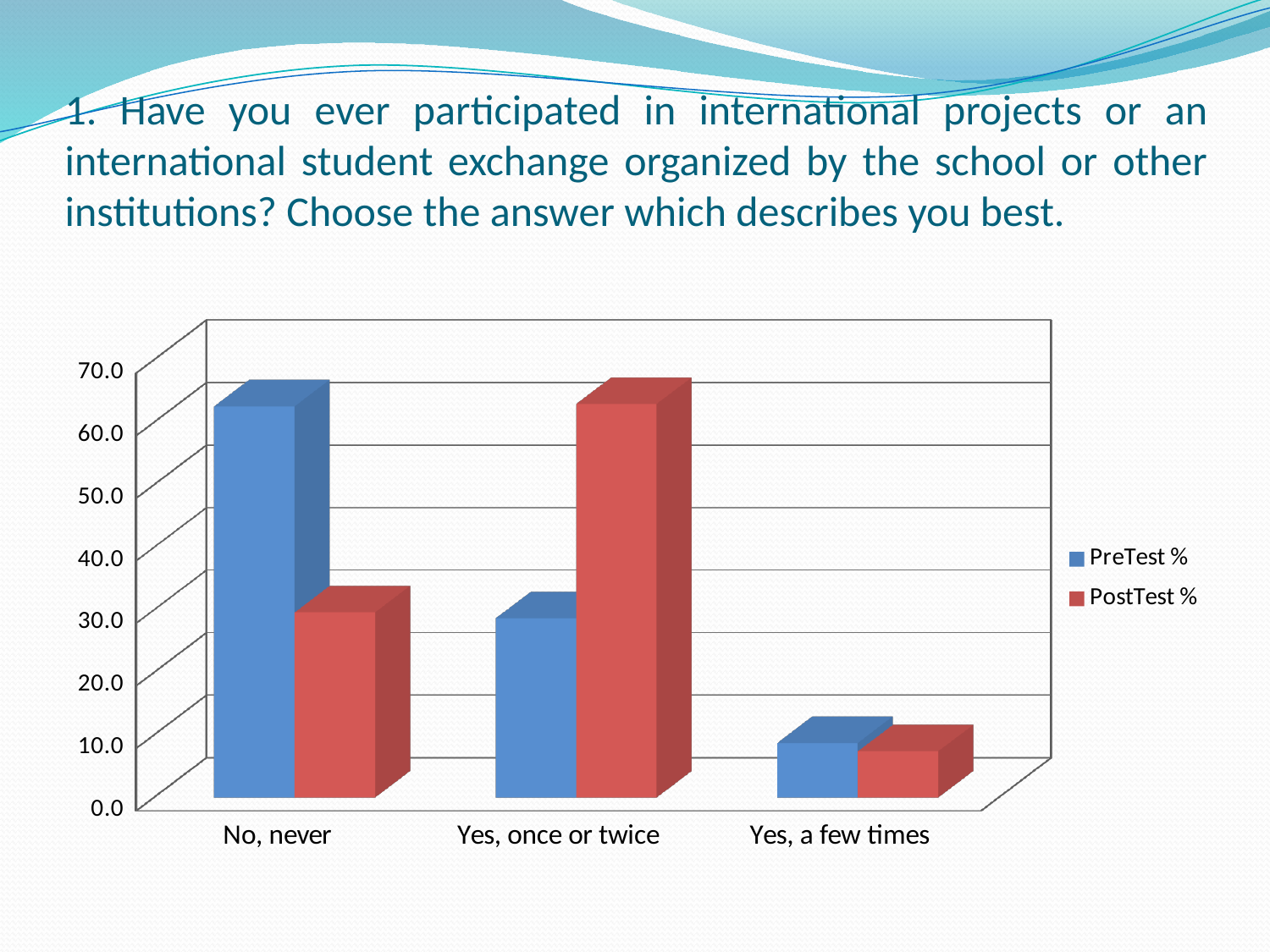
Which category has the highest PreTest % value? No, never Which category has the lowest PreTest % value? Yes, a few times Which category has the lowest PostTest % value? Yes, a few times What kind of chart is shown on the slide? bar chart For the category "Yes, once or twice", which series has the larger value, PreTest % or PostTest %? PostTest % For the category "No, never", which series has the larger value, PreTest % or PostTest %? PreTest % How many series does the legend list? 2 Which category has the highest PostTest % value? Yes, once or twice Which colour represents the PostTest % series in the legend? red Is the PostTest % value for "Yes, a few times" greater or less than 20.0? less How many categories are shown on the x axis? 3 Is the PreTest % value for "No, never" greater or less than 50.0? greater